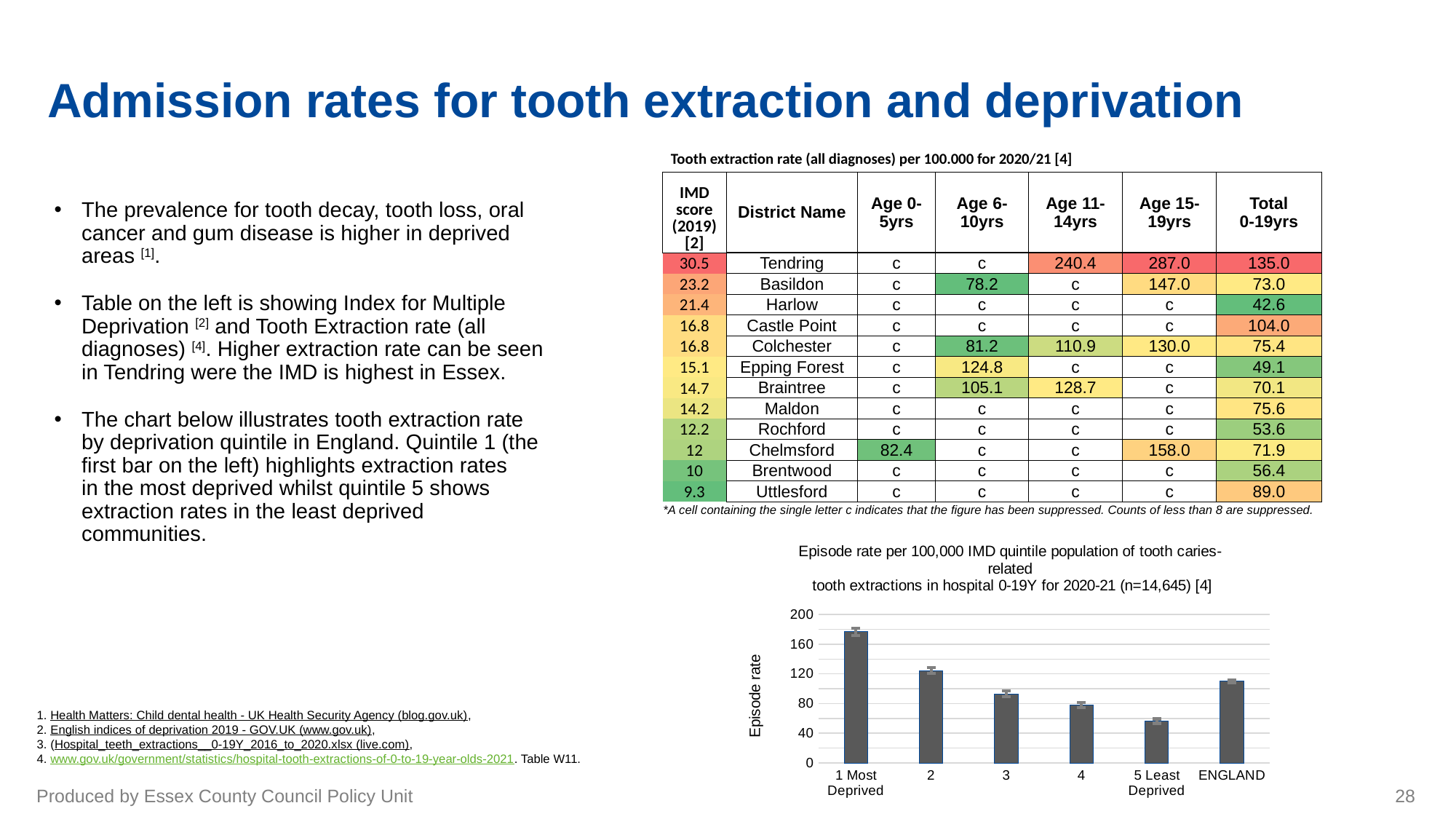
Do the episode rates rise or fall from quintile 1 Most Deprived to quintile 5 Least Deprived? fall Is the episode rate for 5 Least Deprived greater or less than 80? less Which category has the lowest episode rate in the chart? 5 Least Deprived What kind of chart is shown at the bottom right of the slide? bar chart How many bars (categories) does the chart show? 6 Which category has the highest episode rate in the chart? 1 Most Deprived Is the episode rate for ENGLAND greater or less than 120? less Which has a higher episode rate, quintile 2 or ENGLAND? 2 Is the episode rate for quintile 3 greater or less than 80? greater What is the label on the vertical axis of the chart? Episode rate Which has a higher episode rate, quintile 3 or quintile 4? 3